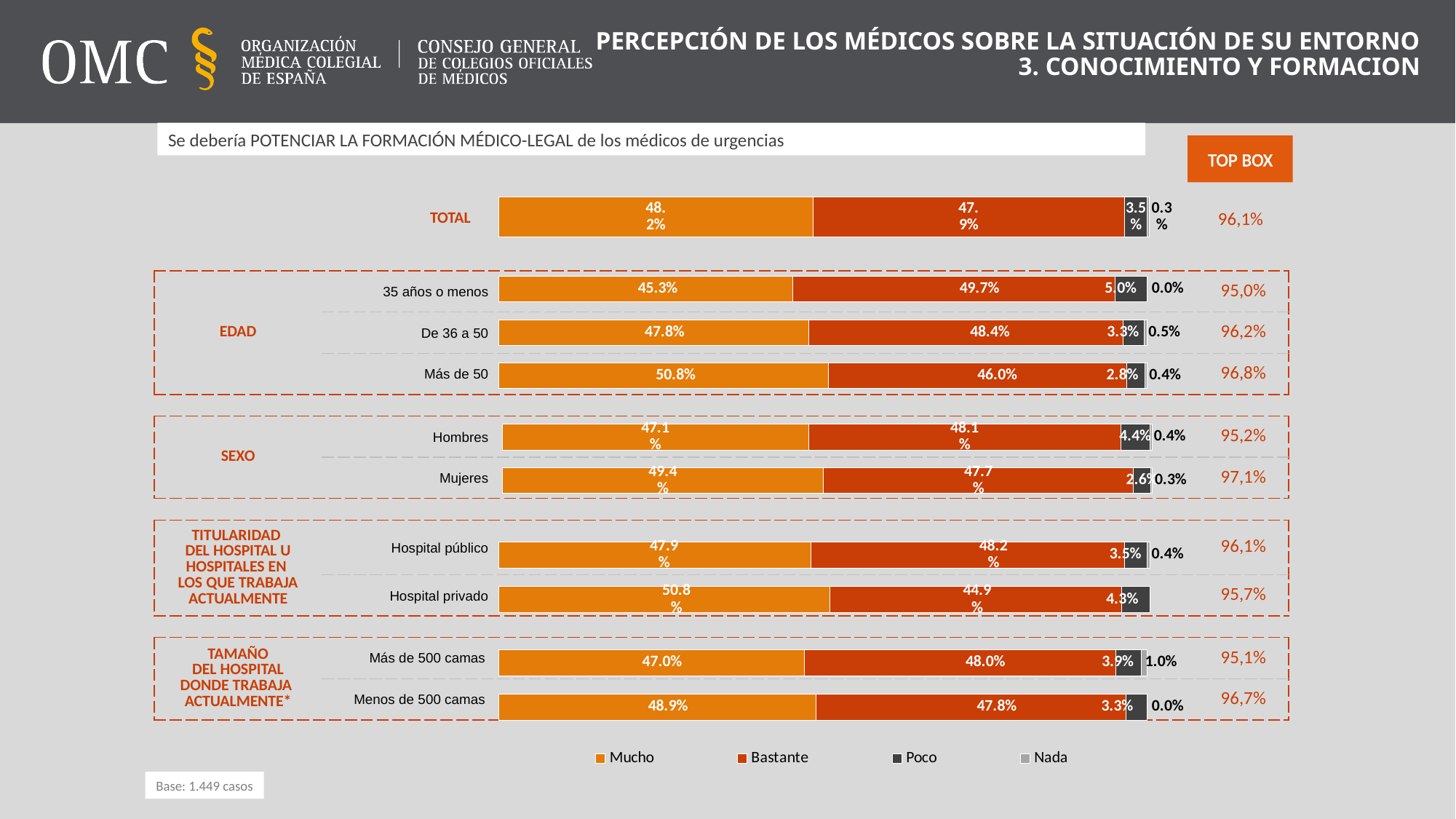
Which has a larger 'Poco' value, 'Hospital público' or 'Hospital privado'? Hospital privado What is the 'Mucho' value for the TOTAL bar? 48.2% What type of chart is shown on the slide? Stacked bar chart How many category bars are plotted in the chart (including TOTAL)? 10 What is the TOP BOX value for 'Mujeres'? 97,1% What is the 'Bastante' value for 'Más de 50'? 46.0% What is the difference between the 'Mucho' values for 'Mujeres' and 'Hombres'? 2.3% Which category has the lowest 'Mucho' value? 35 años o menos What is the combined 'Mucho' and 'Bastante' value for 'Menos de 500 camas'? 96.7% What is the 'Poco' value for '35 años o menos'? 5.0% How many series does the legend list? 4 Which category has the highest 'Bastante' value? 35 años o menos